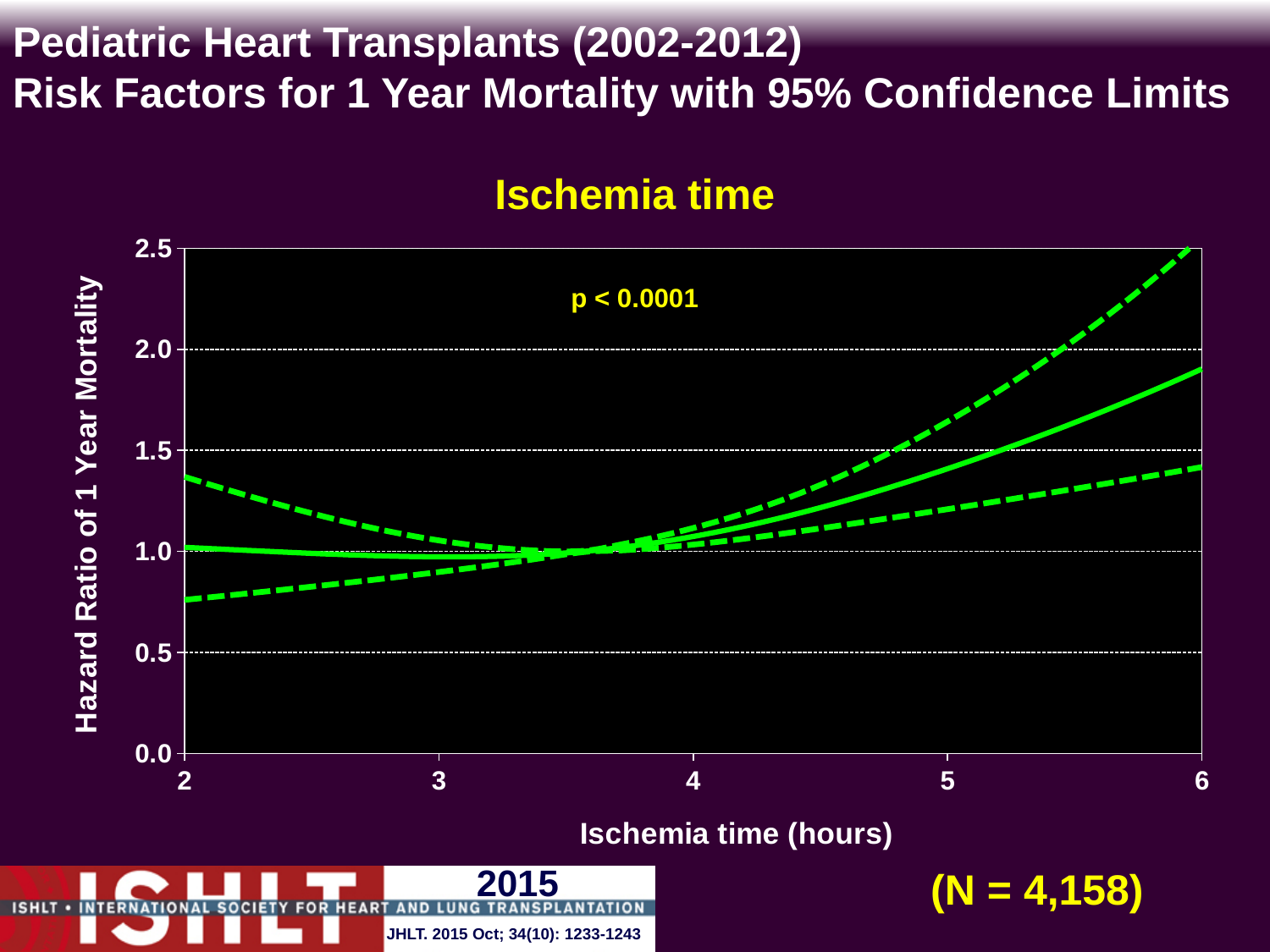
Is the hazard ratio on the solid line at 5 hours greater or less than 1.5? less Is the lower dashed confidence limit at 2 hours greater or less than 1.0? less What kind of chart is shown on the slide? line chart Is the hazard ratio on the solid line at 6 hours greater or less than 1.5? greater What is the sample size (N) shown on the slide? N = 4,158 How many lines are plotted on the chart? 3 What is the title of the chart? Ischemia time Does the solid hazard ratio line rise or fall as ischemia time increases from 4 to 6 hours? rise What is the label of the y axis? Hazard Ratio of 1 Year Mortality What p-value is printed on the chart? p < 0.0001